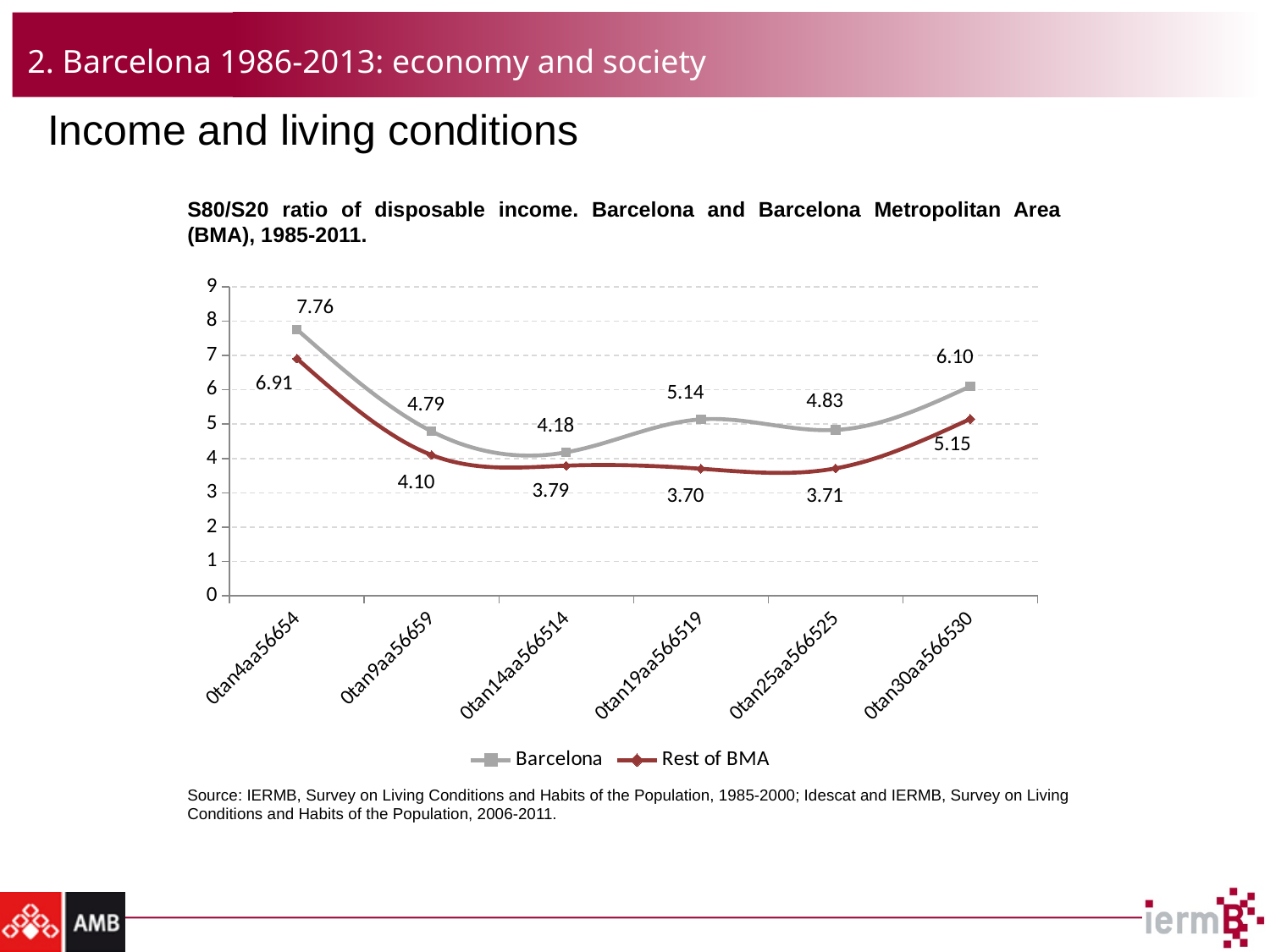
At the fourth point on the x axis, which series has the larger value, Barcelona or Rest of BMA? Barcelona At the first point on the x axis, what is the difference between the Barcelona value and the Rest of BMA value? 0.85 What kind of chart is shown on the slide? line chart What is the value of the Barcelona series at the first point on the x axis? 7.76 What is the highest value of the Barcelona series? 7.76 Does the Barcelona series rise or fall from the first point to the third point on the x axis? fall What are the two series named in the legend? Barcelona and Rest of BMA What is the value of the Rest of BMA series at the last point on the x axis? 5.15 What is the lowest value of the Rest of BMA series? 3.70 How many series does the legend list? 2 How many data points does each line have? 6 At the last point on the x axis, what is the difference between the Barcelona value and the Rest of BMA value? 0.95